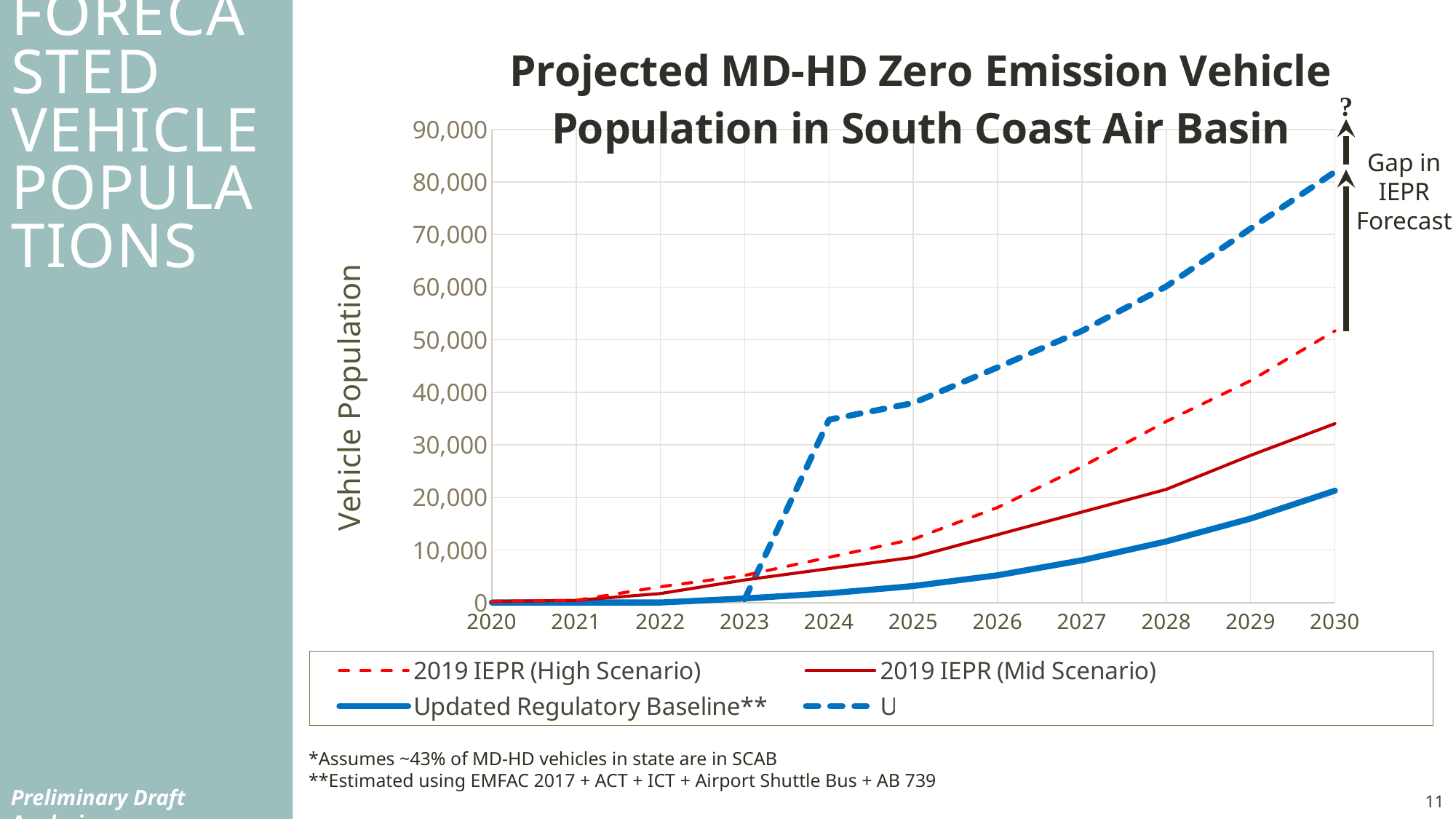
In 2030, which is larger: 2019 IEPR (High Scenario) or 2019 IEPR (Mid Scenario)? 2019 IEPR (High Scenario) How many years are shown along the x axis? 11 Is the value for Updated Regulatory Baseline** in 2030 greater or less than 30,000? less What is the label on the y axis? Vehicle Population What kind of chart is shown on the slide? Line chart What is the title of the chart? Projected MD-HD Zero Emission Vehicle Population in South Coast Air Basin Which series has the highest value in 2030? U Is the value for the U series in 2024 greater or less than 30,000? greater How many series does the legend list? 4 Which series has the lowest value in 2030? Updated Regulatory Baseline** Does the Updated Regulatory Baseline** series rise or fall from 2020 to 2030? rise Is the value for 2019 IEPR (High Scenario) in 2030 greater or less than 40,000? greater